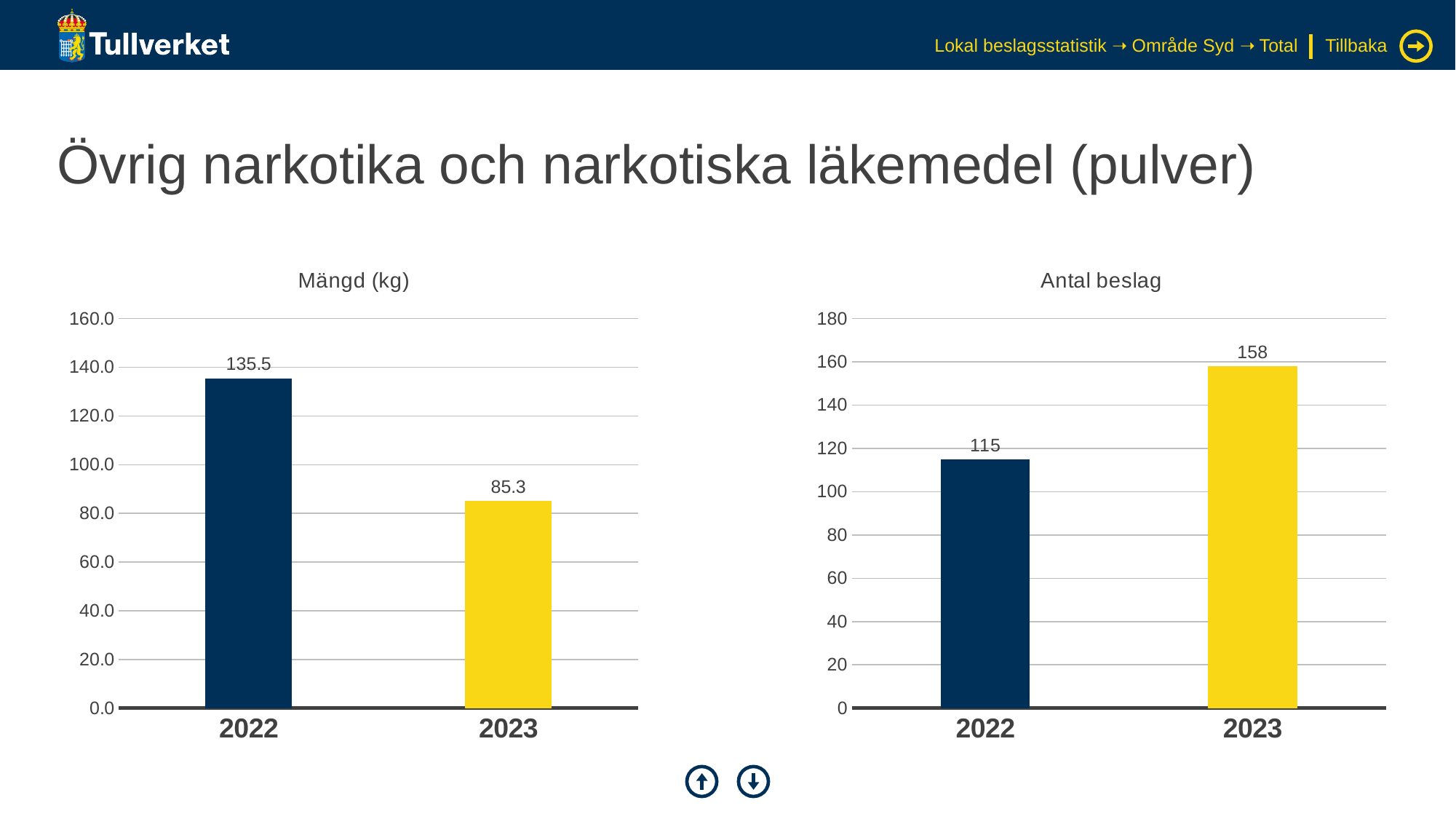
In the 'Antal beslag' chart, what is the difference between the 2023 and 2022 values? 43 In the 'Antal beslag' chart, which year has the lowest value? 2022 In the 'Mängd (kg)' chart, which year has the highest value? 2022 In the 'Mängd (kg)' chart, what is the value for 2022? 135.5 In the 'Mängd (kg)' chart, do the values rise or fall from 2022 to 2023? fall In the 'Mängd (kg)' chart, what is the value for 2023? 85.3 In the 'Antal beslag' chart, which is larger, the value for 2022 or 2023? 2023 In the 'Antal beslag' chart, what is the value for 2023? 158 In the 'Mängd (kg)' chart, what is the difference between the 2022 and 2023 values? 50.2 What kind of chart is the 'Mängd (kg)' chart? bar chart How many categories are shown on the x axis of the 'Antal beslag' chart? 2 In the 'Antal beslag' chart, what is the value for 2022? 115